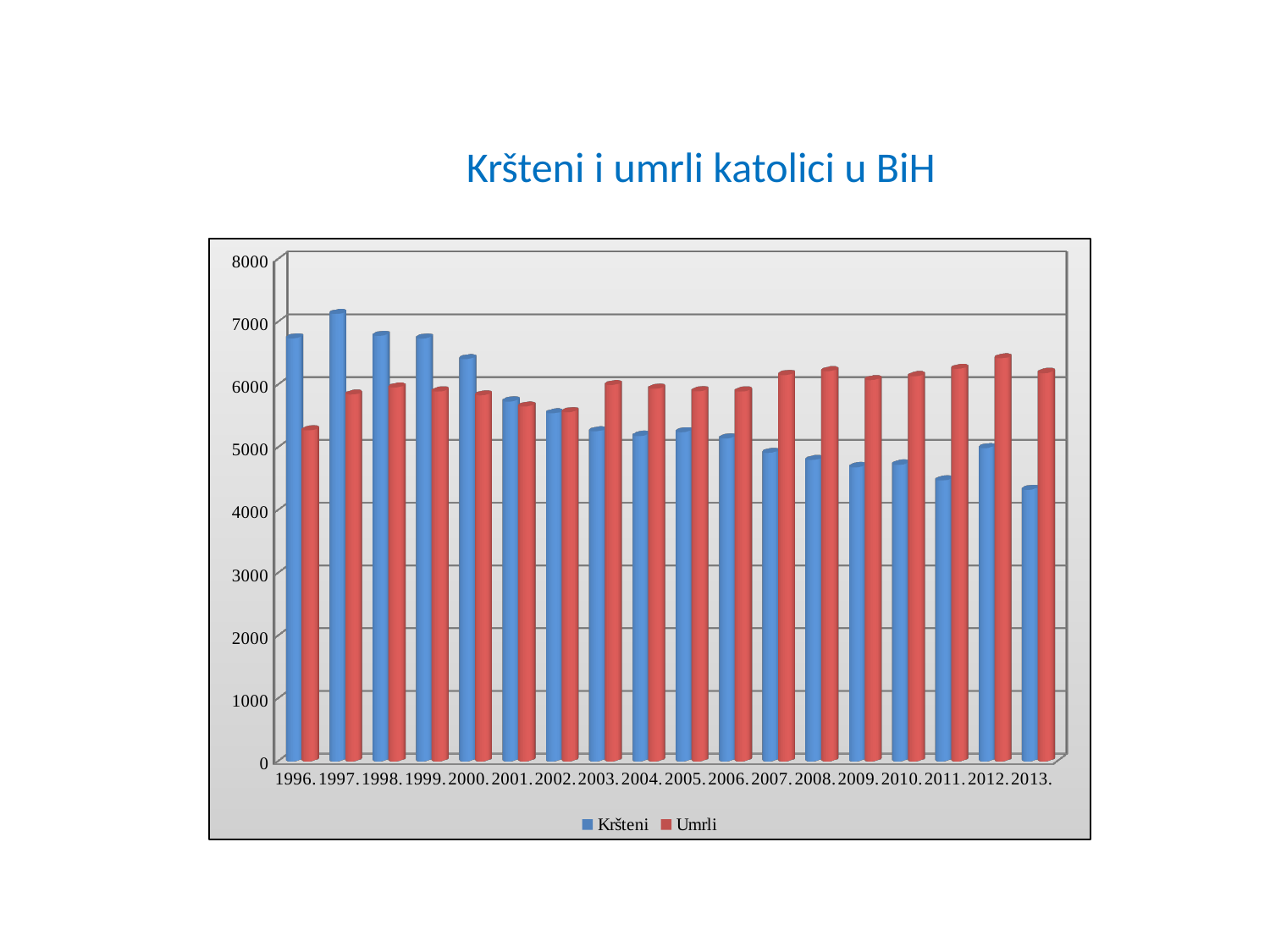
Does the Kršteni series generally rise or fall from 1996 to 2013? fall Is the Kršteni value for 1997 greater or less than 7000? greater In which year is the Kršteni value highest? 1997. In 2013, which is larger, Kršteni or Umrli? Umrli What kind of chart is shown on the slide? bar chart How many series does the legend list? 2 In which year is the Kršteni value lowest? 2013. In 1996, which is larger, Kršteni or Umrli? Kršteni How many years are shown on the x axis? 18 Is the Kršteni value for 2013 greater or less than 5000? less Is the Umrli value for 2012 greater or less than 6000? greater In which year is the Umrli value lowest? 1996.